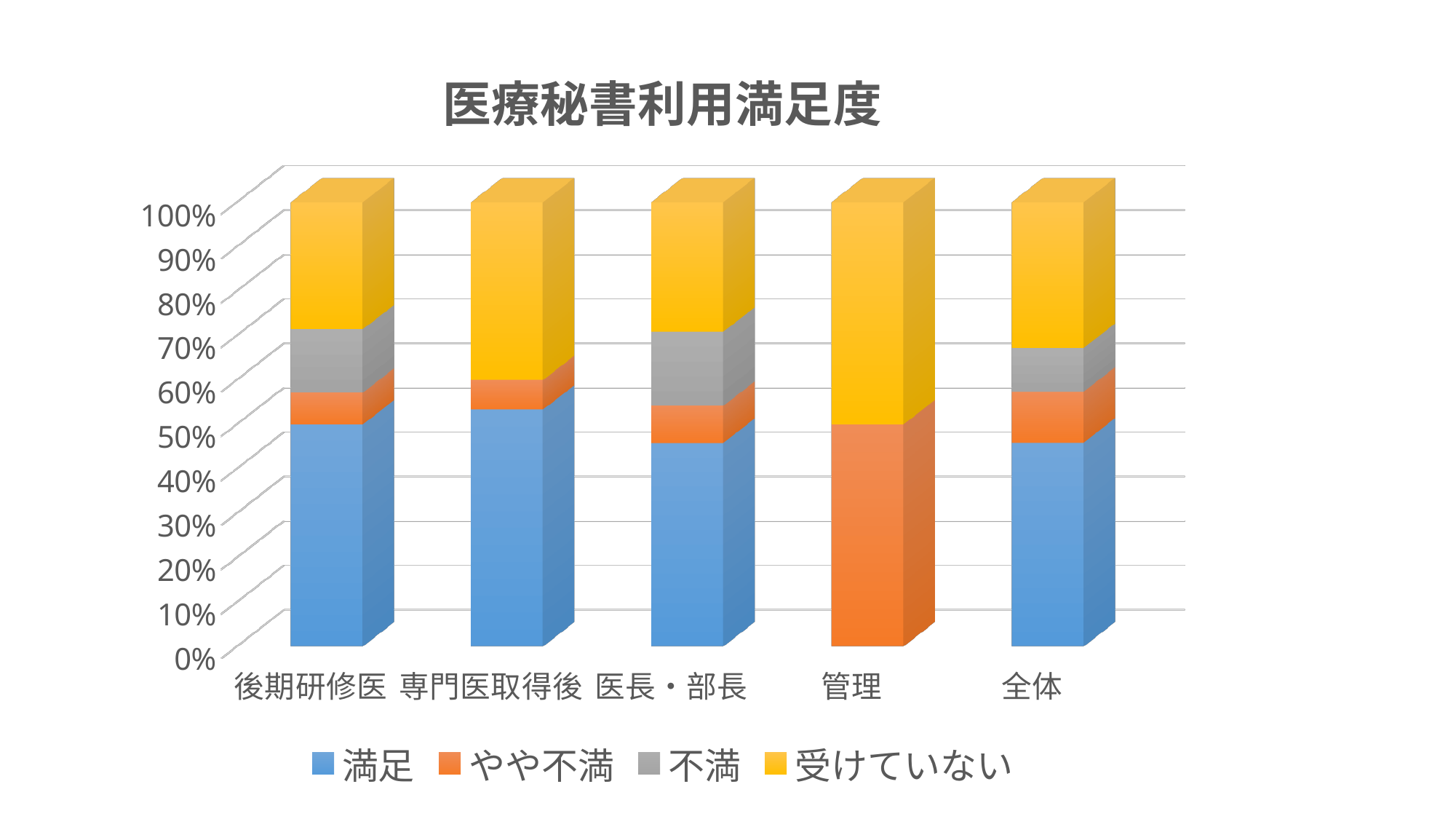
Which category has the largest 受けていない share? 管理 How many series does the legend list? 4 Is the 満足 share for 専門医取得後 greater or less than 50%? greater What kind of chart is shown on the slide? Stacked bar chart Which category has the lowest 満足 share? 管理 Is the 満足 share for 全体 greater or less than 60%? less Is the やや不満 share for 管理 greater or less than 40%? greater Which has the larger 満足 share, 専門医取得後 or 医長・部長? 専門医取得後 Which category has the largest やや不満 share? 管理 Which colour represents 受けていない in the legend? Yellow What is the title of the chart? 医療秘書利用満足度 How many categories are shown on the x axis? 5